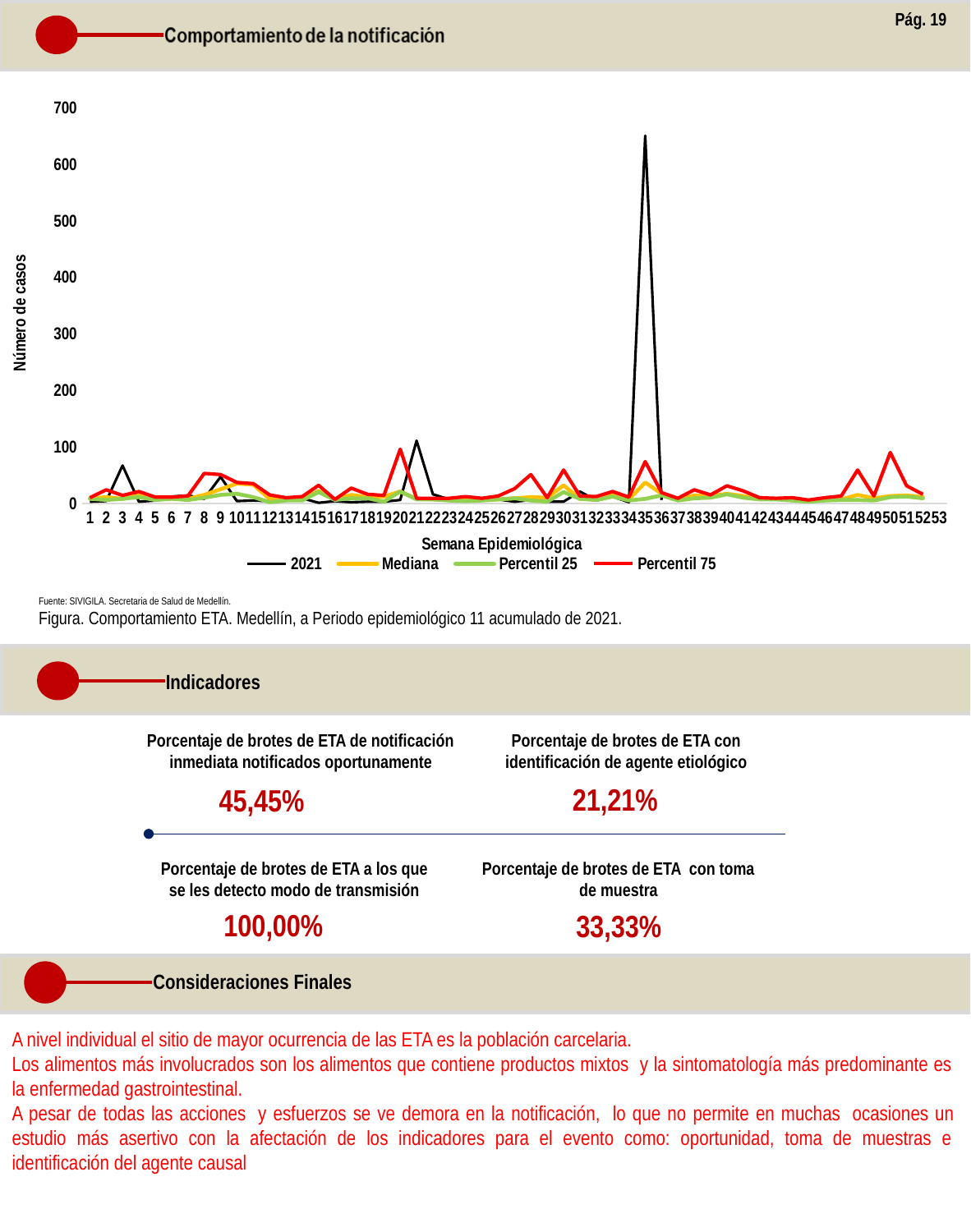
What is the title of the x axis of the chart? Semana Epidemiológica In which epidemiological week does the 2021 series reach its highest value? 35 Is the 2021 value at week 3 greater or less than 100? less At week 20, which series has the larger value, Percentil 75 or Percentil 25? Percentil 75 Is the Percentil 75 value at week 50 greater or less than 200? less Is the 2021 value at week 21 greater or less than 200? less At week 35, which series has the larger value, 2021 or Percentil 75? 2021 How many epidemiological weeks are shown on the x axis of the chart? 53 What kind of chart is shown on the slide? line chart How many series does the chart legend list? 4 What is the title of the y axis of the chart? Número de casos